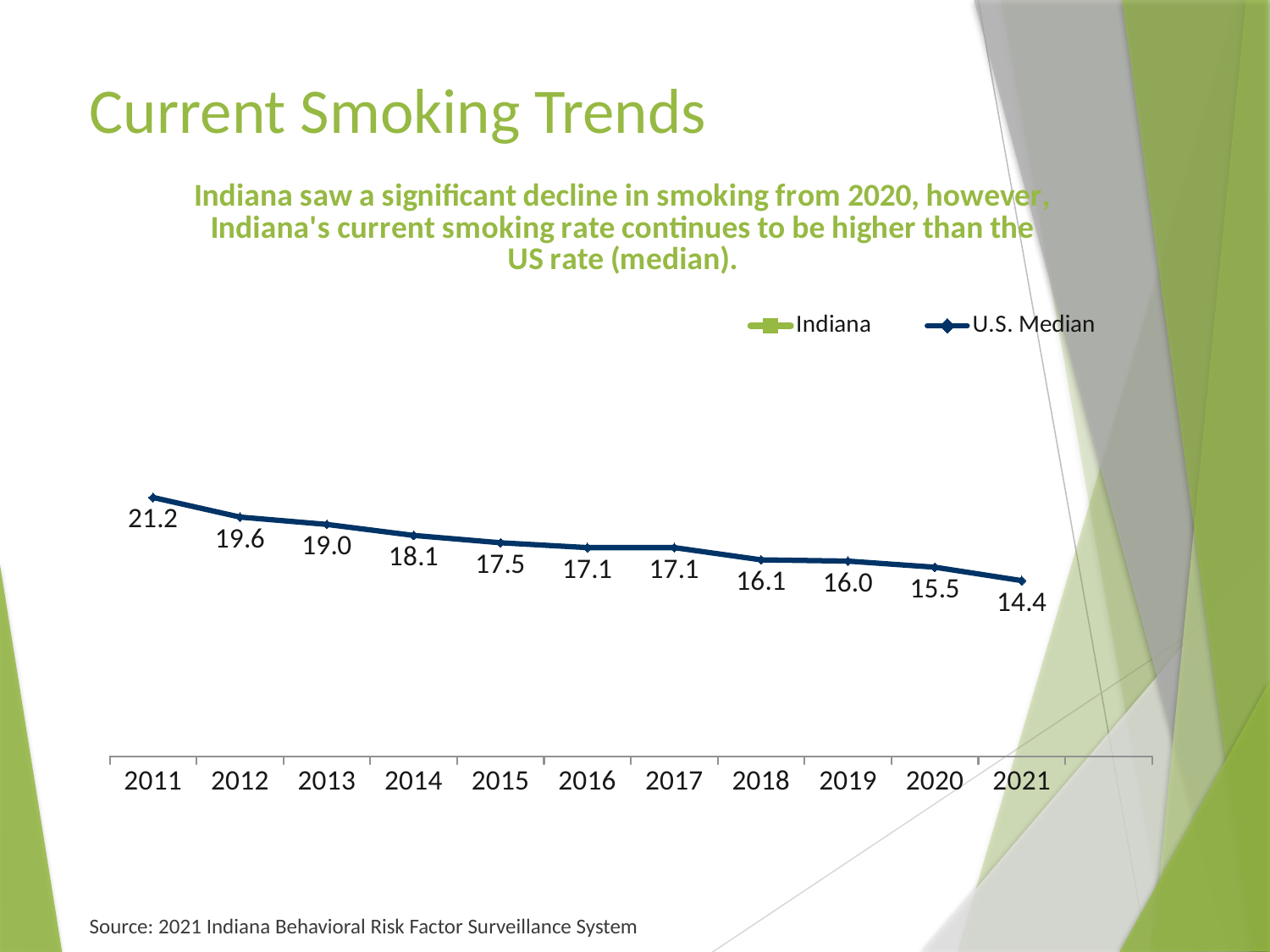
How many years are shown along the x axis of the chart? 11 Is the plotted value for 2013 larger or smaller than the value for 2019? larger What is the value of the plotted line for 2015? 17.5 What is the value of the plotted line for 2011? 21.2 What is the value of the plotted line for 2018? 16.1 What is the difference between the plotted values for 2011 and 2021? 6.8 Do the plotted values rise or fall from 2011 to 2021? fall In which year is the plotted line at its lowest value? 2021 In which year is the plotted line at its highest value? 2011 How many series does the chart legend list? 2 What is the value of the plotted line for 2021? 14.4 What kind of chart is shown on the slide? line chart